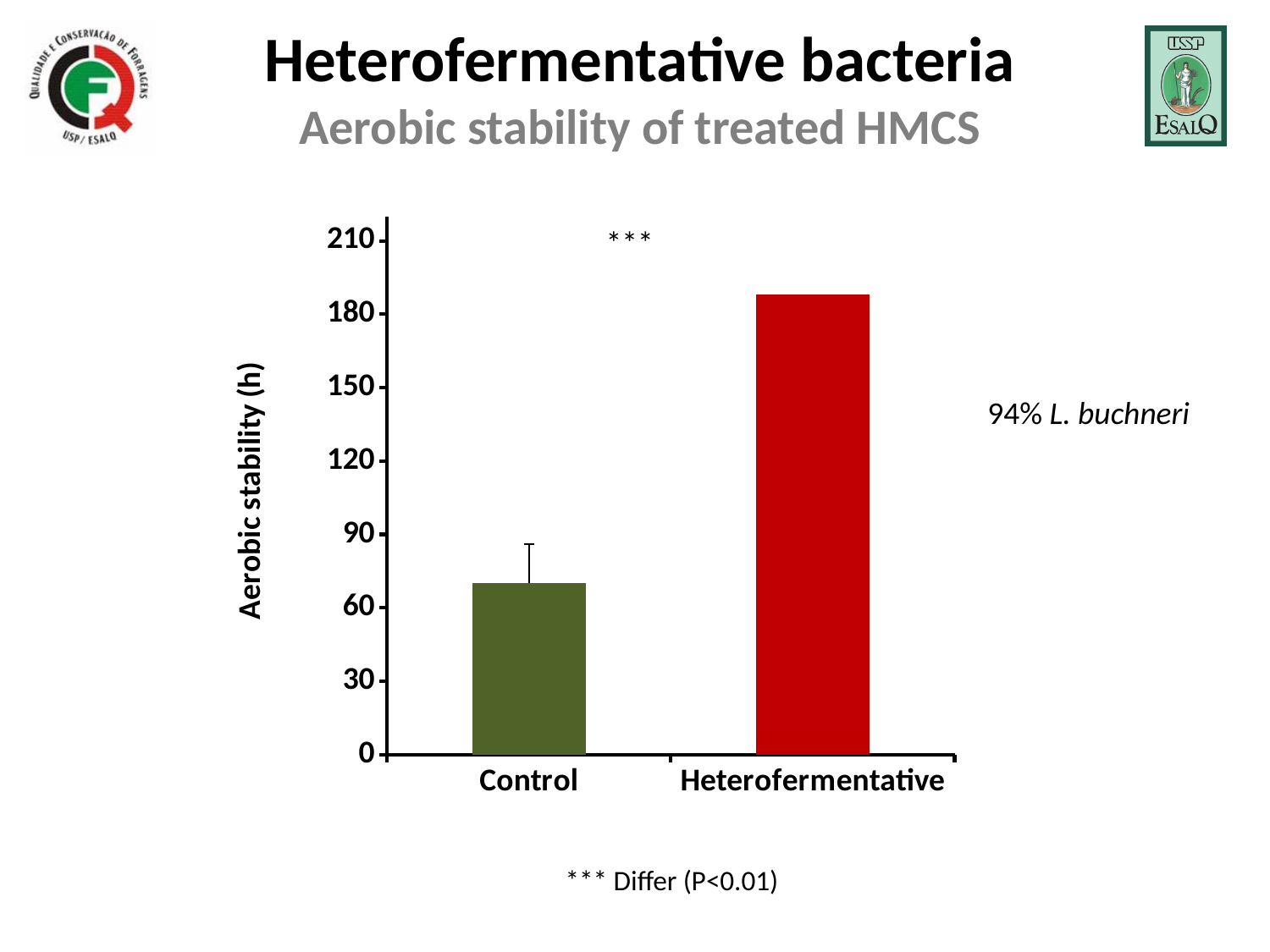
What is the label of the y axis of the chart? Aerobic stability (h) What kind of chart is shown on the slide? bar chart Which category has the highest aerobic stability? Heterofermentative Which has a larger aerobic stability value, Control or Heterofermentative? Heterofermentative Is the value for Control greater or less than 60? greater What colour is the bar for the Heterofermentative category? red Is the value for Heterofermentative greater or less than 150? greater Is the value for Heterofermentative greater or less than 210? less How many categories are plotted on the x axis of the chart? 2 Which category has the lowest aerobic stability? Control